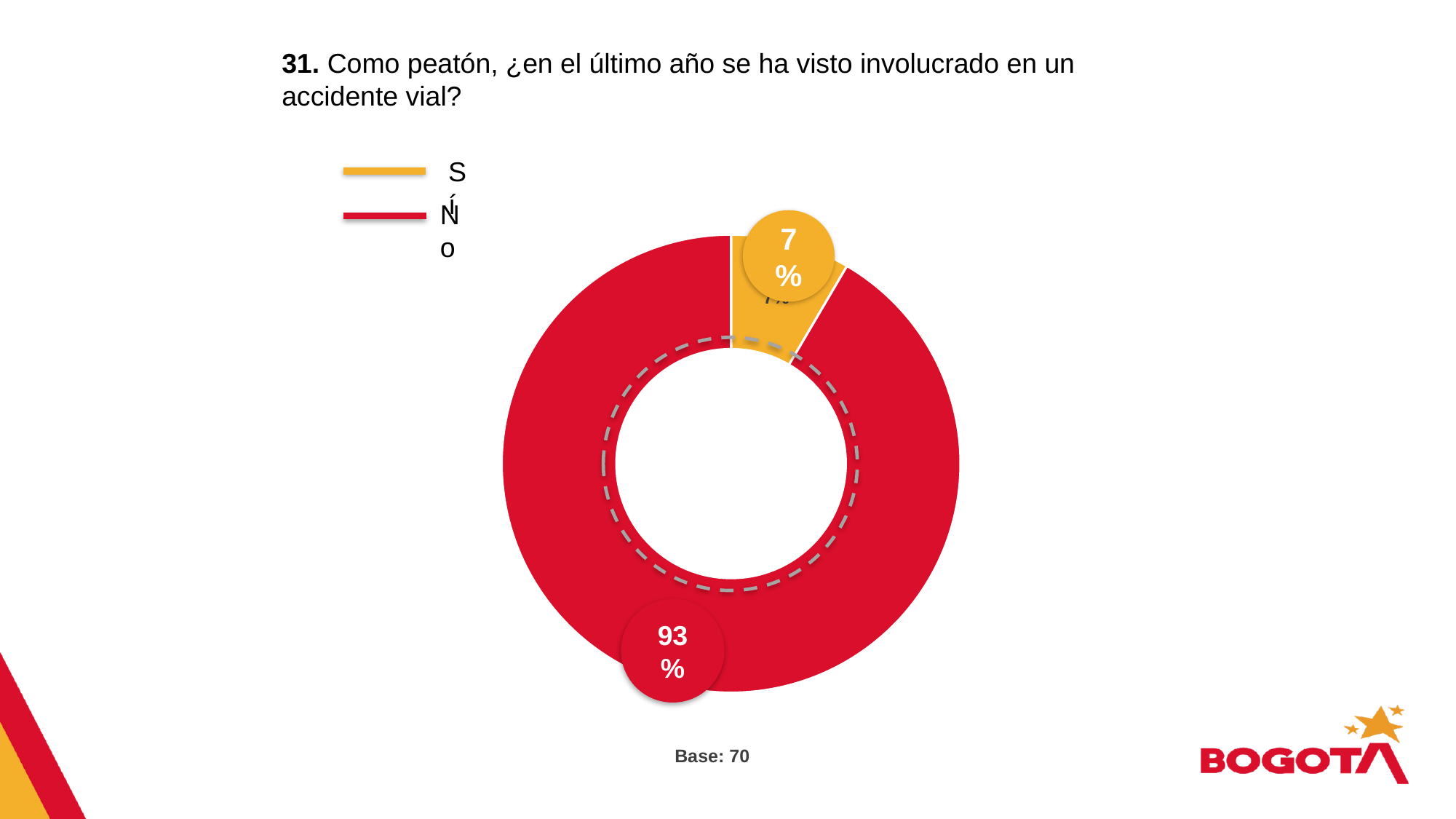
Which is larger, the share for "Sí" or the share for "No"? No Which response has the largest share of the chart? No Which response has the smallest share of the chart? Sí How many entries does the legend list? 2 What kind of chart is shown on the slide? Donut (pie) chart How many categories are shown in the chart? 2 What colour represents the "No" response in the chart? Red What percentage of respondents answered "No"? 93% What is the combined share of the "Sí" and "No" slices? 100% What is the base (number of respondents) stated below the chart? 70 What percentage of respondents answered "Sí"? 7% What is the difference in percentage points between the "No" and "Sí" responses? 86